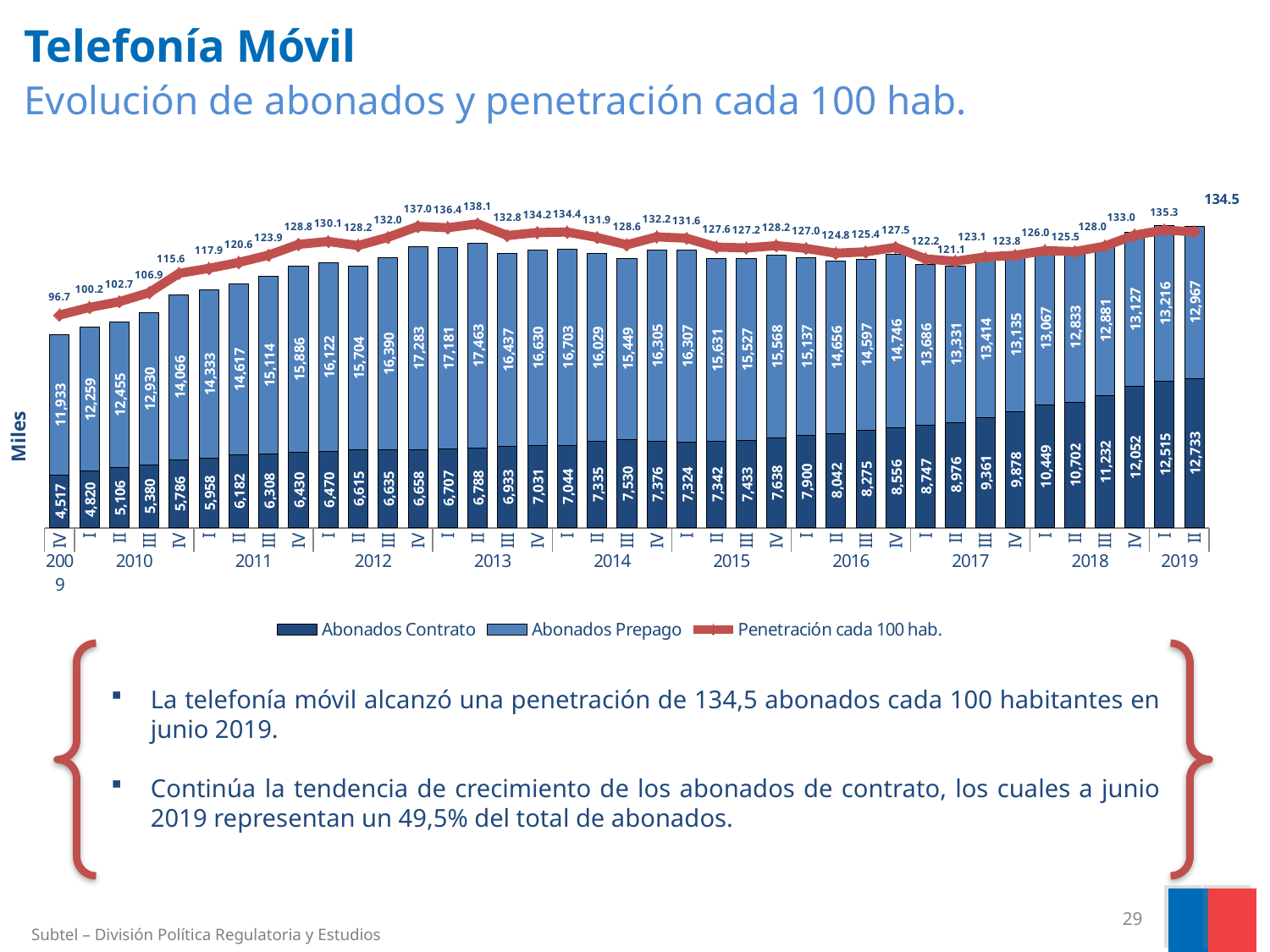
What kind of chart is shown on the slide? Stacked bar chart with a line In which quarter is Abonados Contrato at its lowest? IV 2009 In which quarter is Abonados Prepago at its highest? II 2013 What is the value of Abonados Prepago for II 2019? 12,967 How many series does the legend list? 3 What is the value of Abonados Contrato for II 2019? 12,733 What is the total of the stacked bar (Abonados Contrato plus Abonados Prepago) for II 2019? 25,700 In which quarter does Penetración cada 100 hab. reach its highest value? II 2013 Does Abonados Contrato rise or fall from IV 2009 to II 2019? Rise What is the difference between Abonados Prepago and Abonados Contrato in II 2019? 234 Which is larger, Abonados Prepago in I 2019 or in II 2019? I 2019 What is the Penetración cada 100 hab. value for IV 2009? 96.7